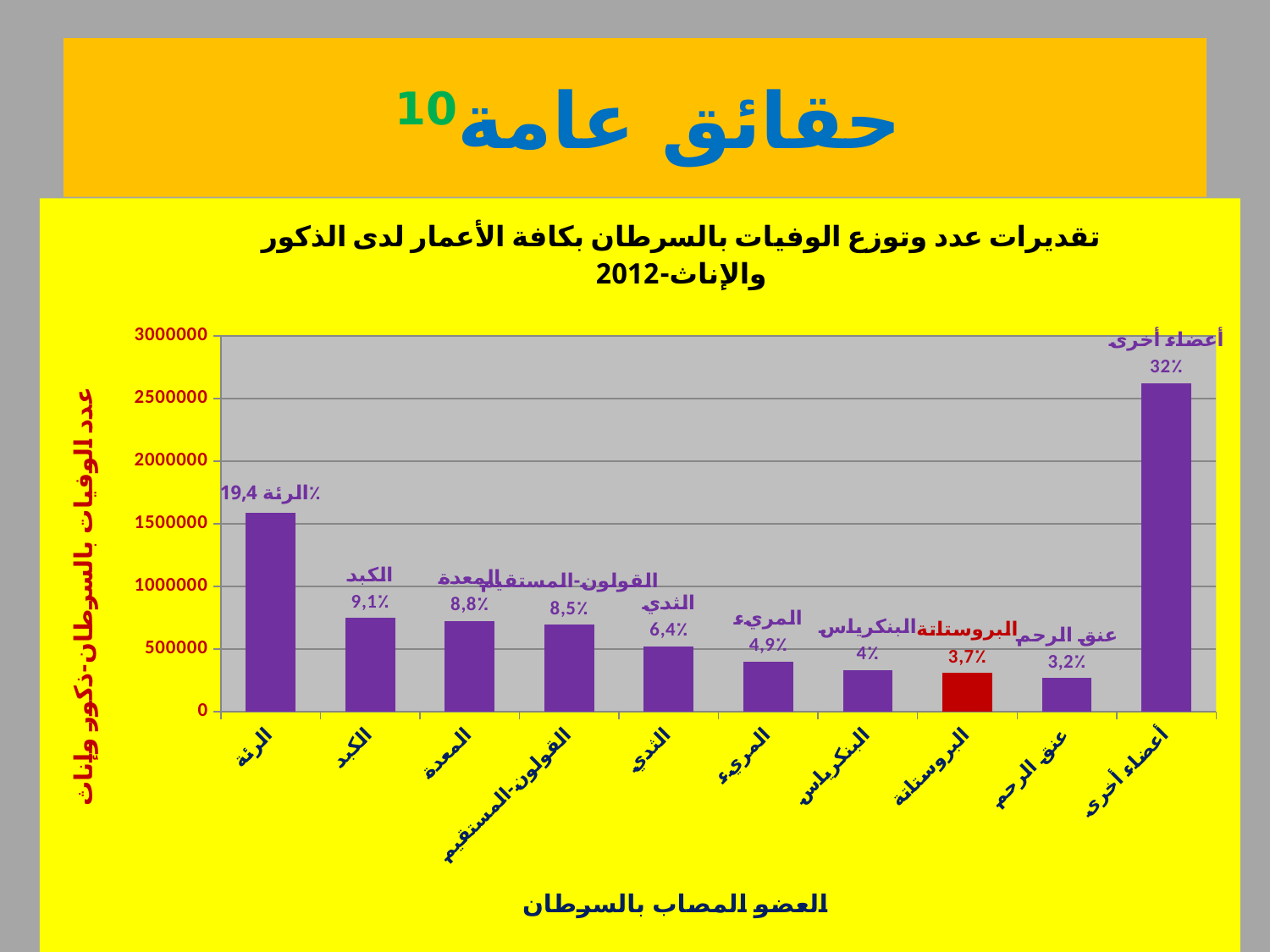
What type of chart is shown on the slide? Bar chart Is the value for أعضاء أخرى greater or less than 2500000? greater Which category has the highest bar in the chart? أعضاء أخرى How many categories (organs) are shown on the x axis of the chart? 10 What percentage label is shown for أعضاء أخرى? 32% Which bar in the chart is coloured red instead of purple? البروستاتة What percentage label is shown for الرئة? 19,4% Which has a larger percentage label, الكبد or المعدة? الكبد What percentage label is shown for البروستاتة? 3,7% What is the difference between the percentage labels for أعضاء أخرى and الرئة? 12,6% What percentage label is shown for الثدي? 6,4% Which category has the lowest bar in the chart? عنق الرحم